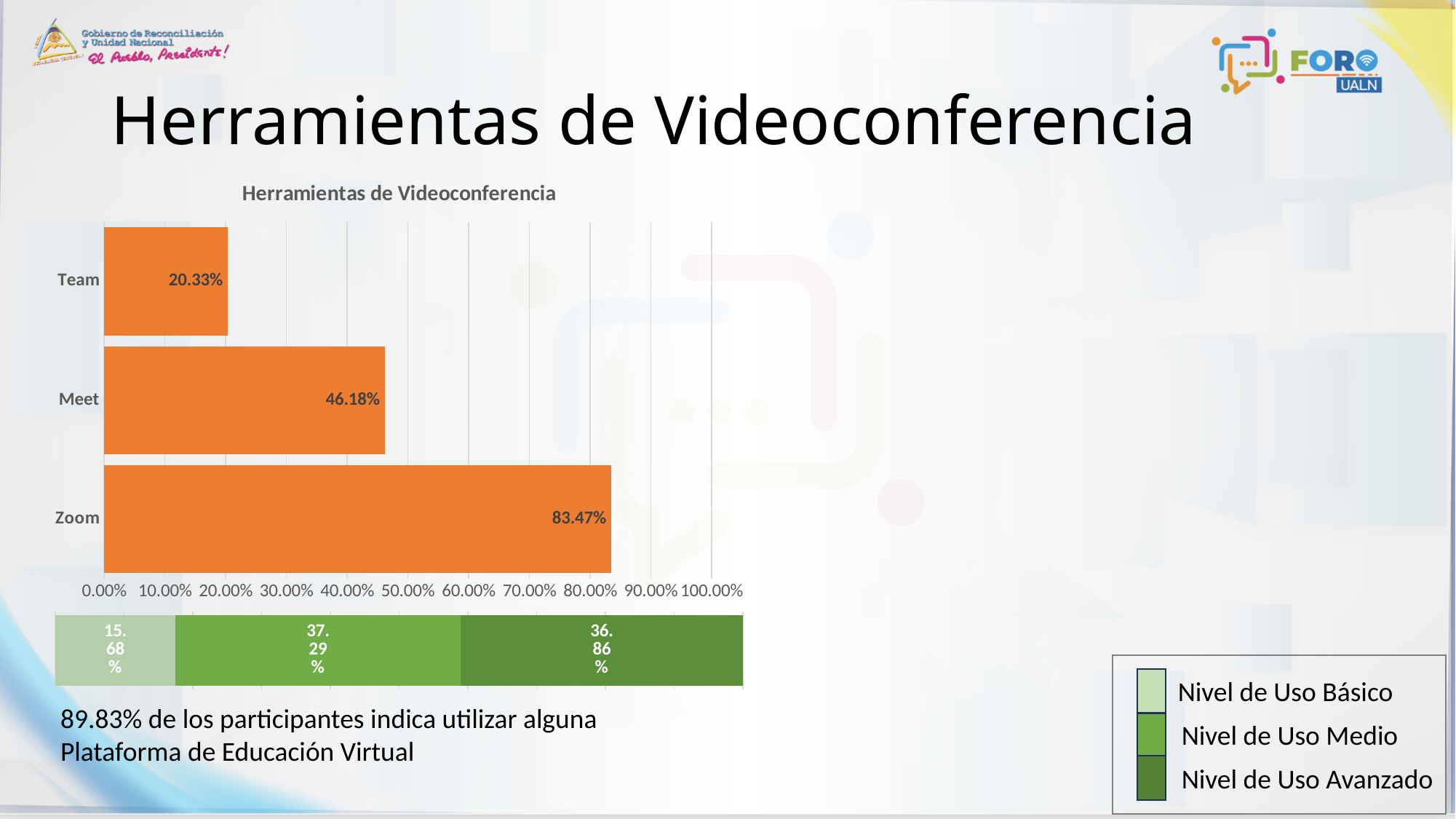
In the bar chart titled Herramientas de Videoconferencia, what is the value for Team? 20.33% In the bar chart titled Herramientas de Videoconferencia, what is the value for Zoom? 83.47% In the bar chart titled Herramientas de Videoconferencia, which tool has the highest value? Zoom In the bar chart titled Herramientas de Videoconferencia, which is larger, the value for Meet or the value for Team? Meet In the bar chart titled Herramientas de Videoconferencia, what is the value for Meet? 46.18% In the green stacked bar below the bar chart, what is the value for Nivel de Uso Básico? 15.68% How many tools are shown in the bar chart titled Herramientas de Videoconferencia? 3 In the bar chart titled Herramientas de Videoconferencia, what is the difference between the values for Zoom and Team? 63.14% How many series does the legend for the green stacked bar list? 3 What kind of chart is the chart titled Herramientas de Videoconferencia? bar chart In the bar chart titled Herramientas de Videoconferencia, which tool has the lowest value? Team In the green stacked bar below the bar chart, what is the value for Nivel de Uso Medio? 37.29%